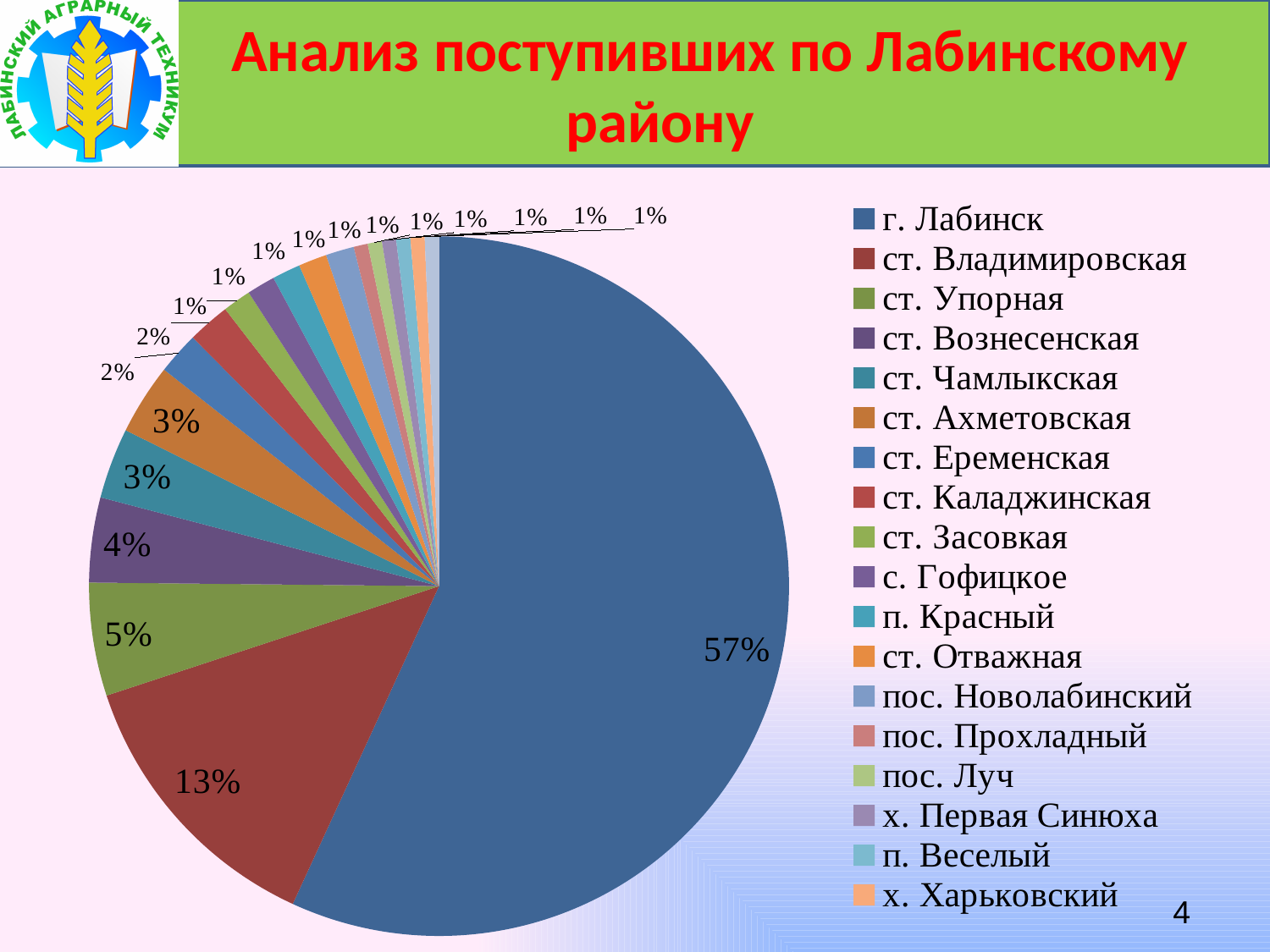
Which is larger, the share of ст. Упорная or the share of ст. Вознесенская? ст. Упорная What is the difference between the shares of г. Лабинск and ст. Владимировская? 44% How many categories does the legend list? 18 What is the value shown for ст. Упорная? 5% Which category has the largest slice of the pie? г. Лабинск What is the title of the slide containing the chart? Анализ поступивших по Лабинскому району Which legend entry is listed last? х. Харьковский What is the value shown for ст. Владимировская? 13% What kind of chart is shown on the slide? Pie chart What share of the pie does г. Лабинск hold? 57% What is the difference between the shares of ст. Владимировская and ст. Упорная? 8% What is the value shown for ст. Вознесенская? 4%